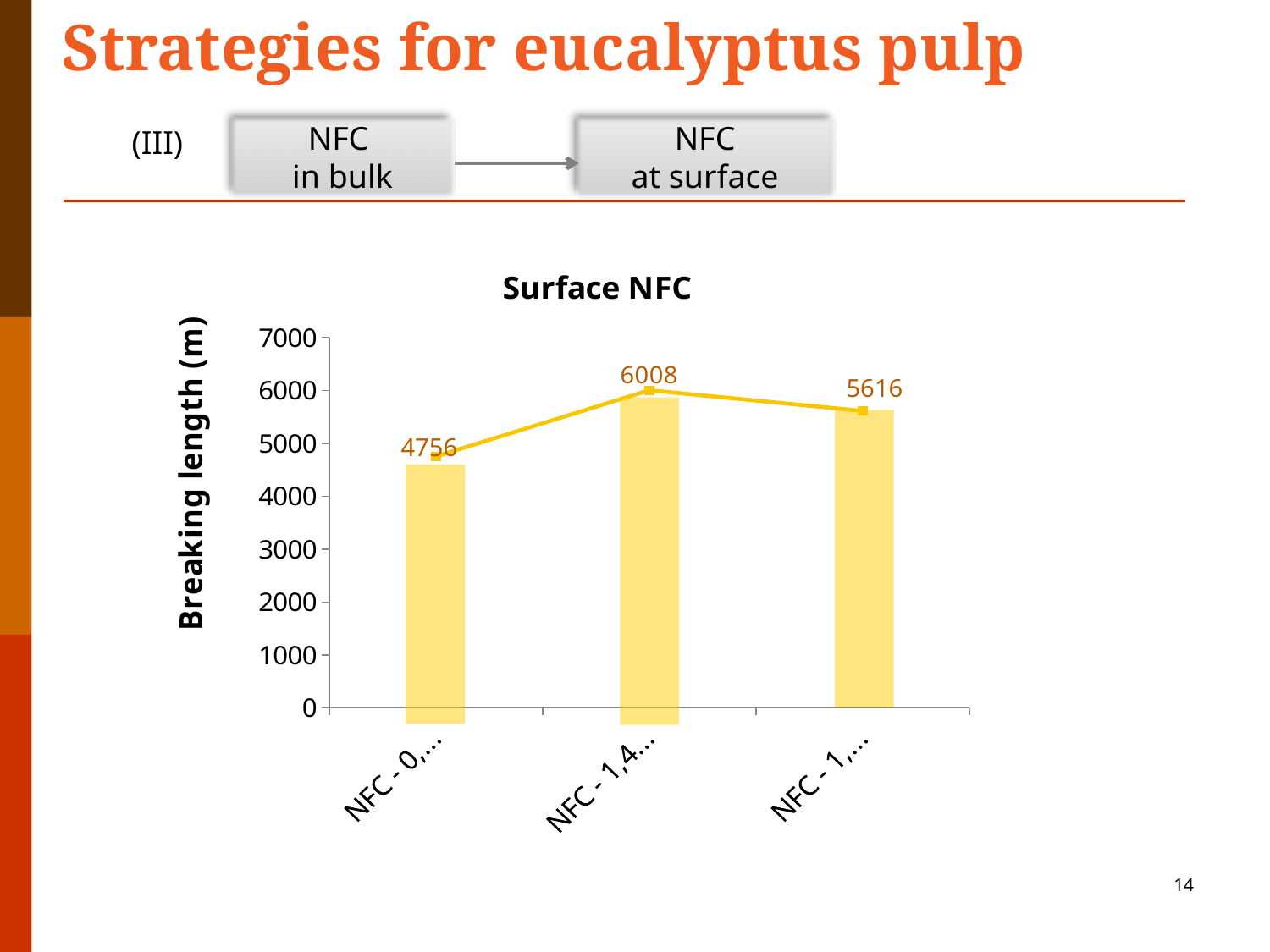
Which bar has the highest breaking length in the Surface NFC chart? The middle (second) bar What kind of chart is shown on the slide? Bar chart with a line overlay What is the value of the middle bar in the Surface NFC chart? 6008 Which bar has the lowest breaking length in the Surface NFC chart? The first (leftmost) bar Is the value of the leftmost bar in the Surface NFC chart greater or less than 5000? less Which is larger in the Surface NFC chart, the leftmost bar or the rightmost bar? The rightmost bar What is the difference between the highest value and the lowest value in the Surface NFC chart? 1252 What is the value of the third (rightmost) bar in the Surface NFC chart? 5616 What is the value of the first (leftmost) bar in the Surface NFC chart? 4756 What is the label of the vertical axis in the Surface NFC chart? Breaking length (m) By how much does the middle bar exceed the rightmost bar in the Surface NFC chart? 392 How many bars are plotted in the Surface NFC chart? 3